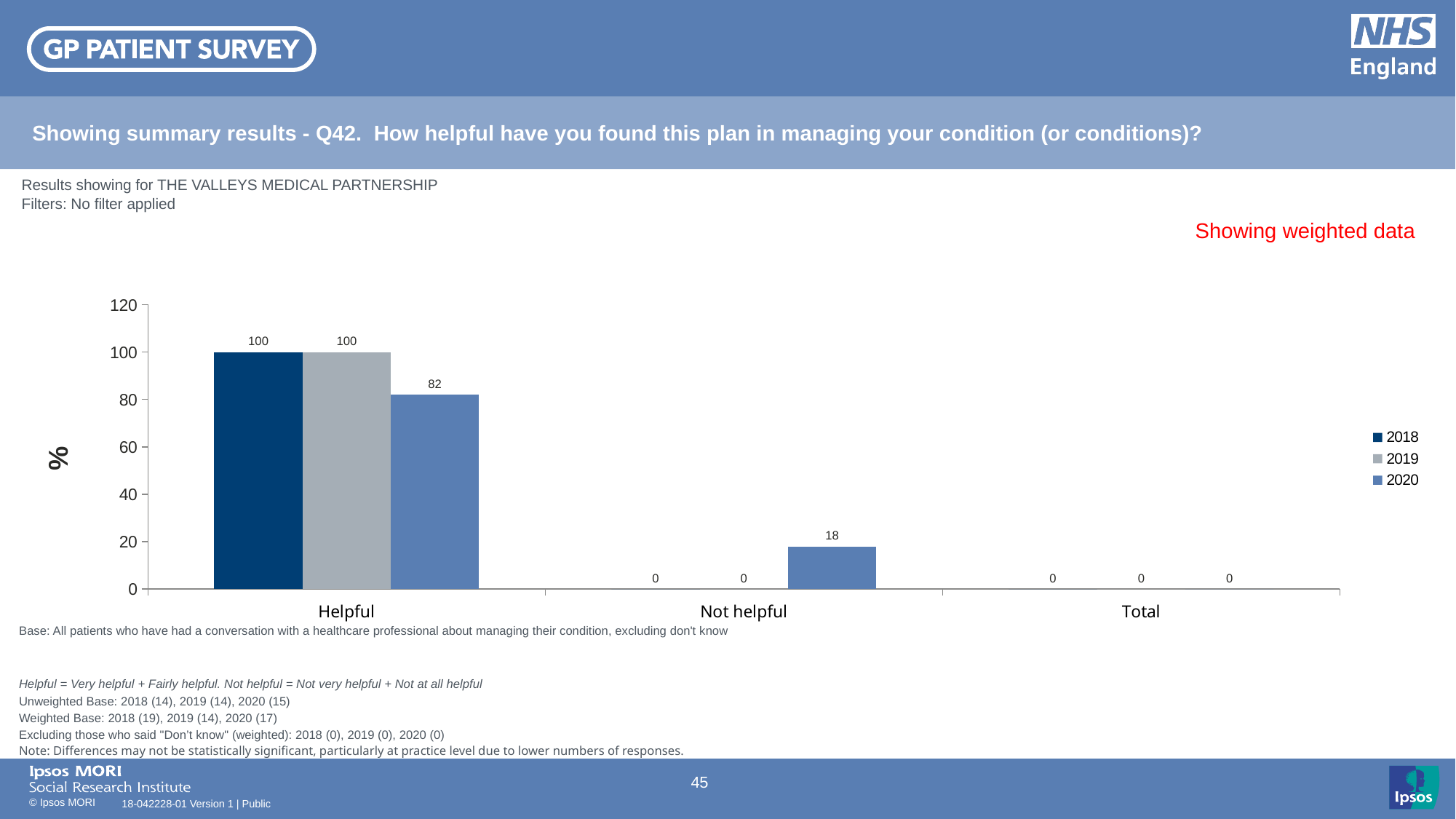
What is the difference between the 2019 and 2020 values in the Helpful category? 18 What kind of chart is shown on the slide? bar chart How many categories are shown on the x axis? 3 Which year has the lowest value in the Helpful category? 2020 What is the value for 2019 in the Not helpful category? 0 Which year has the highest value in the Not helpful category? 2020 What is the value for 2018 in the Helpful category? 100 What is the value for 2020 in the Helpful category? 82 Is the 2020 value for Helpful larger or smaller than the 2020 value for Not helpful? larger How many series does the legend list? 3 What is the label on the vertical axis? % What is the value for 2020 in the Not helpful category? 18